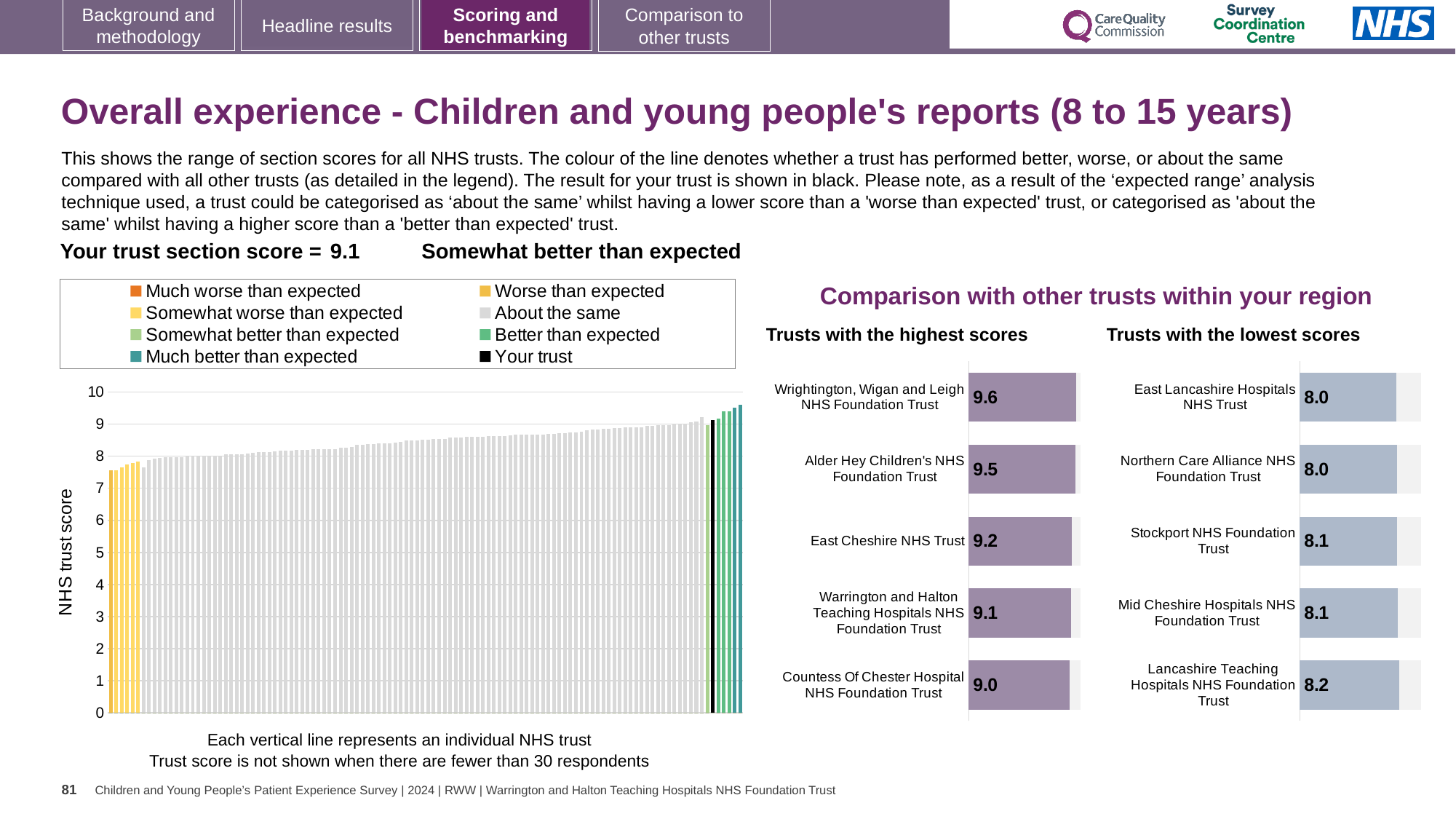
In the 'Trusts with the lowest scores' chart, which has the larger score: Stockport NHS Foundation Trust or Lancashire Teaching Hospitals NHS Foundation Trust? Lancashire Teaching Hospitals NHS Foundation Trust In the 'Trusts with the highest scores' chart, what is the score for Wrightington, Wigan and Leigh NHS Foundation Trust? 9.6 In the 'Trusts with the lowest scores' chart, what is the difference between the scores of Lancashire Teaching Hospitals NHS Foundation Trust and East Lancashire Hospitals NHS Trust? 0.2 How many trusts are shown in the 'Trusts with the highest scores' chart? 5 What kind of chart is the large chart on the left showing NHS trust scores? Bar chart In the 'Trusts with the lowest scores' chart, which trust has the highest score? Lancashire Teaching Hospitals NHS Foundation Trust In the 'Trusts with the highest scores' chart, which trust has the highest score? Wrightington, Wigan and Leigh NHS Foundation Trust In the 'Trusts with the lowest scores' chart, what is the score for Lancashire Teaching Hospitals NHS Foundation Trust? 8.2 How many entries does the legend of the left-hand chart list? 8 In the 'Trusts with the lowest scores' chart, what is the score for Stockport NHS Foundation Trust? 8.1 In the 'Trusts with the highest scores' chart, what is the difference between the scores of Wrightington, Wigan and Leigh NHS Foundation Trust and Countess Of Chester Hospital NHS Foundation Trust? 0.6 In the 'Trusts with the highest scores' chart, what is the score for East Cheshire NHS Trust? 9.2